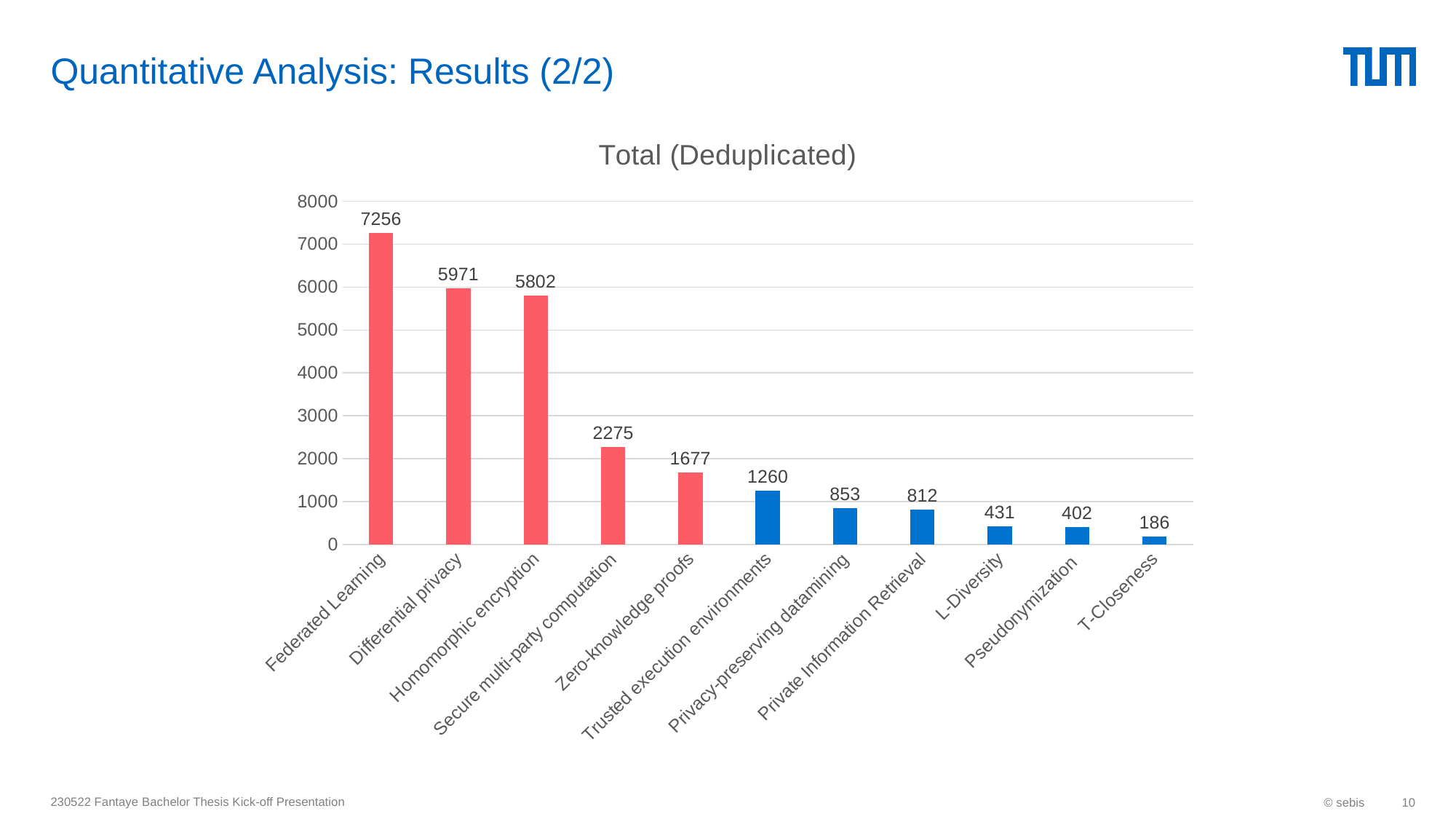
Which is larger, Privacy-preserving datamining or Private Information Retrieval? Privacy-preserving datamining What is the difference between Secure multi-party computation and Zero-knowledge proofs? 598 What is the difference between Federated Learning and Differential privacy? 1285 What is the value for Pseudonymization? 402 What is the title of the chart? Total (Deduplicated) Which category has the lowest value? T-Closeness What kind of chart is shown on the slide? bar chart What is the value for Federated Learning? 7256 Is the value for Homomorphic encryption greater or less than 5000? greater How many categories are shown in the chart? 11 Which category has the highest value? Federated Learning What is the value for Trusted execution environments? 1260